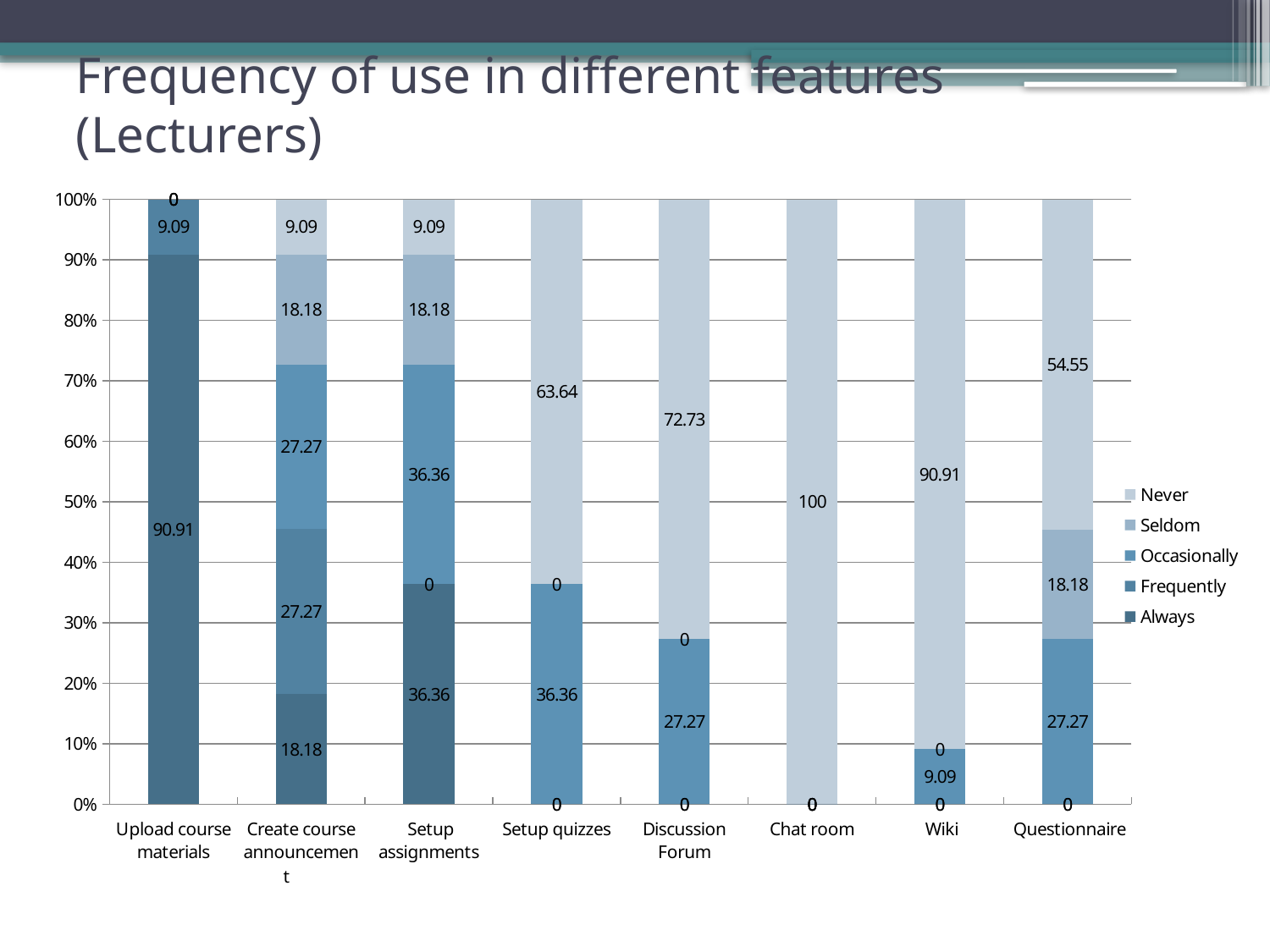
What is the 'Always' value for Upload course materials? 90.91 What is the 'Always' value for Create course announcement? 18.18 How many series does the legend list? 5 Which feature has the highest 'Always' value? Upload course materials Which has the larger 'Never' value, Discussion Forum or Setup quizzes? Discussion Forum What is the 'Occasionally' value for Setup quizzes? 36.36 What is the difference between the 'Never' value for Wiki and the 'Never' value for Discussion Forum? 18.18 Which feature has the highest 'Never' value? Chat room How many feature categories are shown on the x axis? 8 What kind of chart is shown on the slide? Stacked bar chart What is the 'Never' value for Chat room? 100 What is the 'Never' value for Questionnaire? 54.55